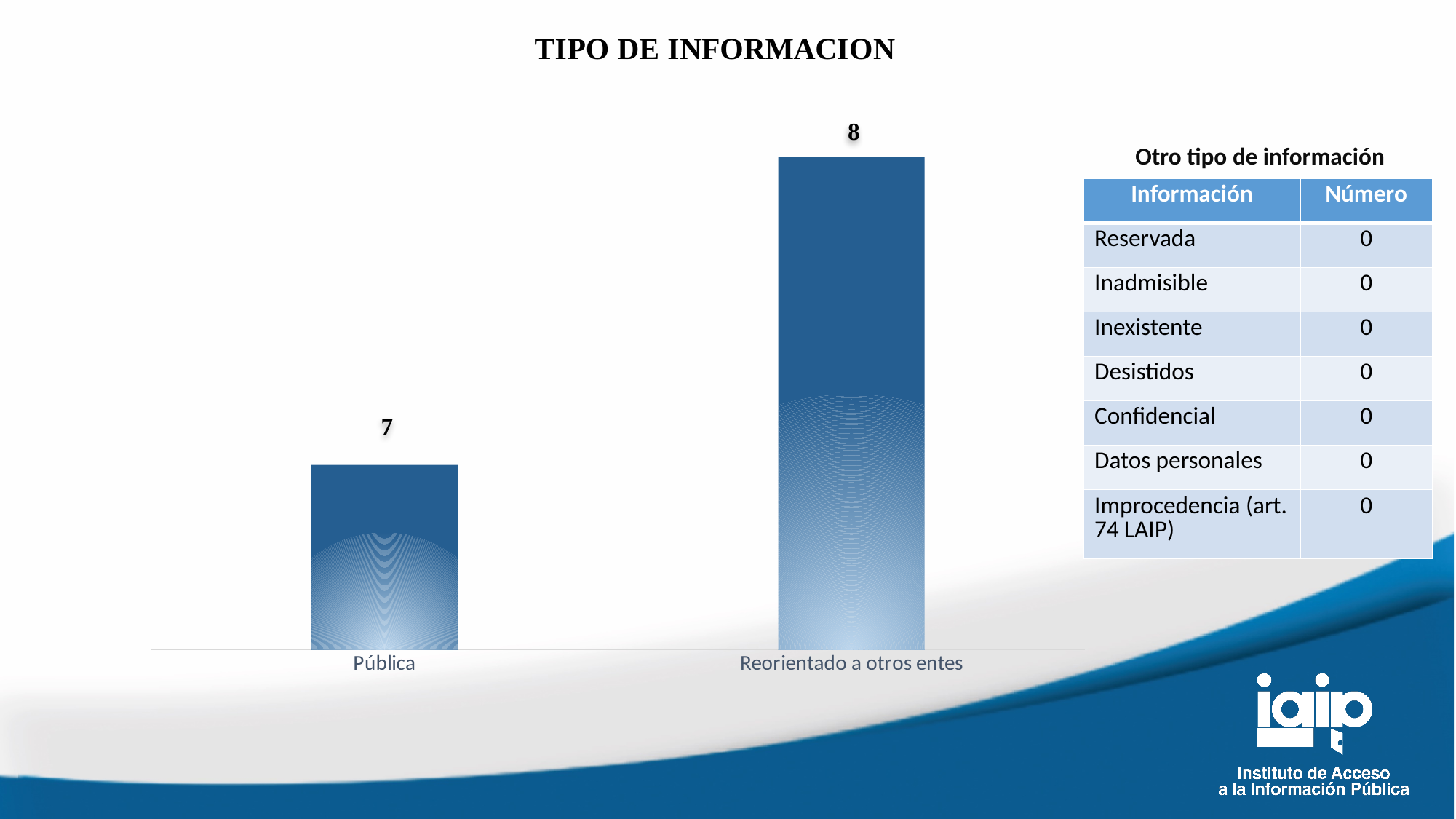
What is the difference between the values for Reorientado a otros entes and Pública? 1 What is the value for Reorientado a otros entes? 8 How many categories are shown in the chart? 2 What is the title of the chart? TIPO DE INFORMACION Which category has the highest value? Reorientado a otros entes What is the value for Pública? 7 What is the total of the two bar values in the chart? 15 Which is larger, the value for Pública or the value for Reorientado a otros entes? Reorientado a otros entes What kind of chart is shown on the slide? Bar chart Do the values rise or fall from left to right along the x axis? Rise Which category has the lowest value? Pública